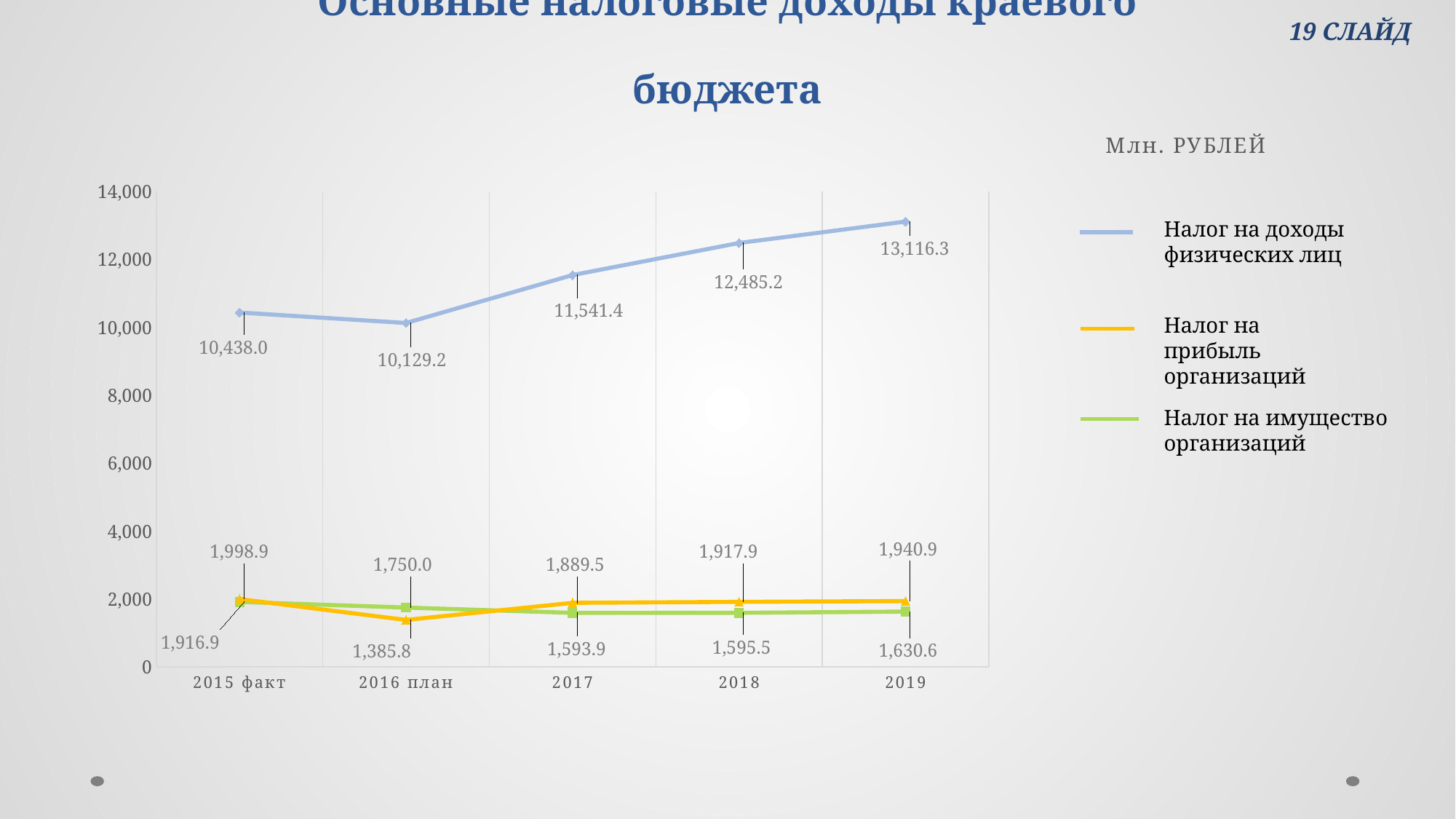
How many periods are shown on the x axis? 5 In which year is Налог на доходы физических лиц highest? 2019 How many series does the legend list? 3 For 2016 план, which is larger: Налог на прибыль организаций or Налог на имущество организаций? Налог на имущество организаций What is the difference between Налог на доходы физических лиц in 2019 and in 2015 факт? 2,678.3 What is the value of Налог на доходы физических лиц in 2019? 13,116.3 Is the value of Налог на доходы физических лиц in 2018 greater or less than 12,000? greater In which period is Налог на доходы физических лиц lowest? 2016 план What is the value of Налог на прибыль организаций for 2016 план? 1,385.8 Does Налог на доходы физических лиц rise or fall from 2016 план to 2019? rise What is the value of Налог на имущество организаций in 2017? 1,593.9 What kind of chart is shown on the slide? line chart